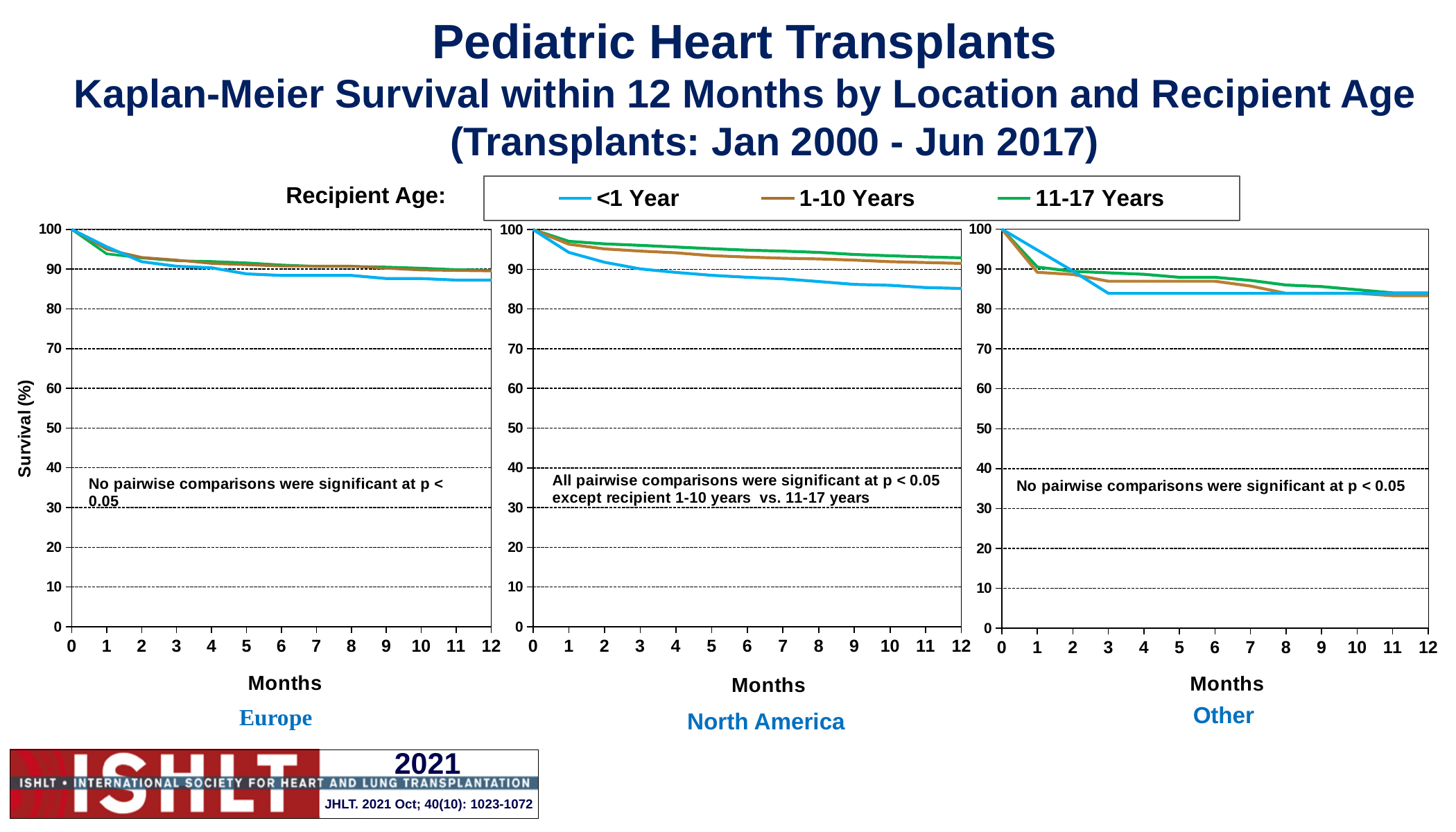
In the North America chart, which is higher at 12 months: <1 Year or 11-17 Years? 11-17 Years In the Other chart, is the survival for <1 Year at 12 months greater or less than 80? greater How many recipient age series does the legend list? 3 In the Europe chart, which recipient age group has the lowest survival at 12 months? <1 Year In the North America chart, which recipient age group has the lowest survival at 12 months? <1 Year In the Europe chart, does survival rise or fall as months increase? fall In the North America chart, what is the survival value for all three age groups at month 0? 100 What is the label of the y axis on the Europe chart? Survival (%) What kind of chart is used for the Europe panel? line chart In the Europe chart, is the survival for 11-17 Years at 12 months greater or less than 80? greater In the North America chart, is the survival for <1 Year at 12 months greater or less than 90? less In the Other chart, which is higher at month 1: <1 Year or 1-10 Years? <1 Year